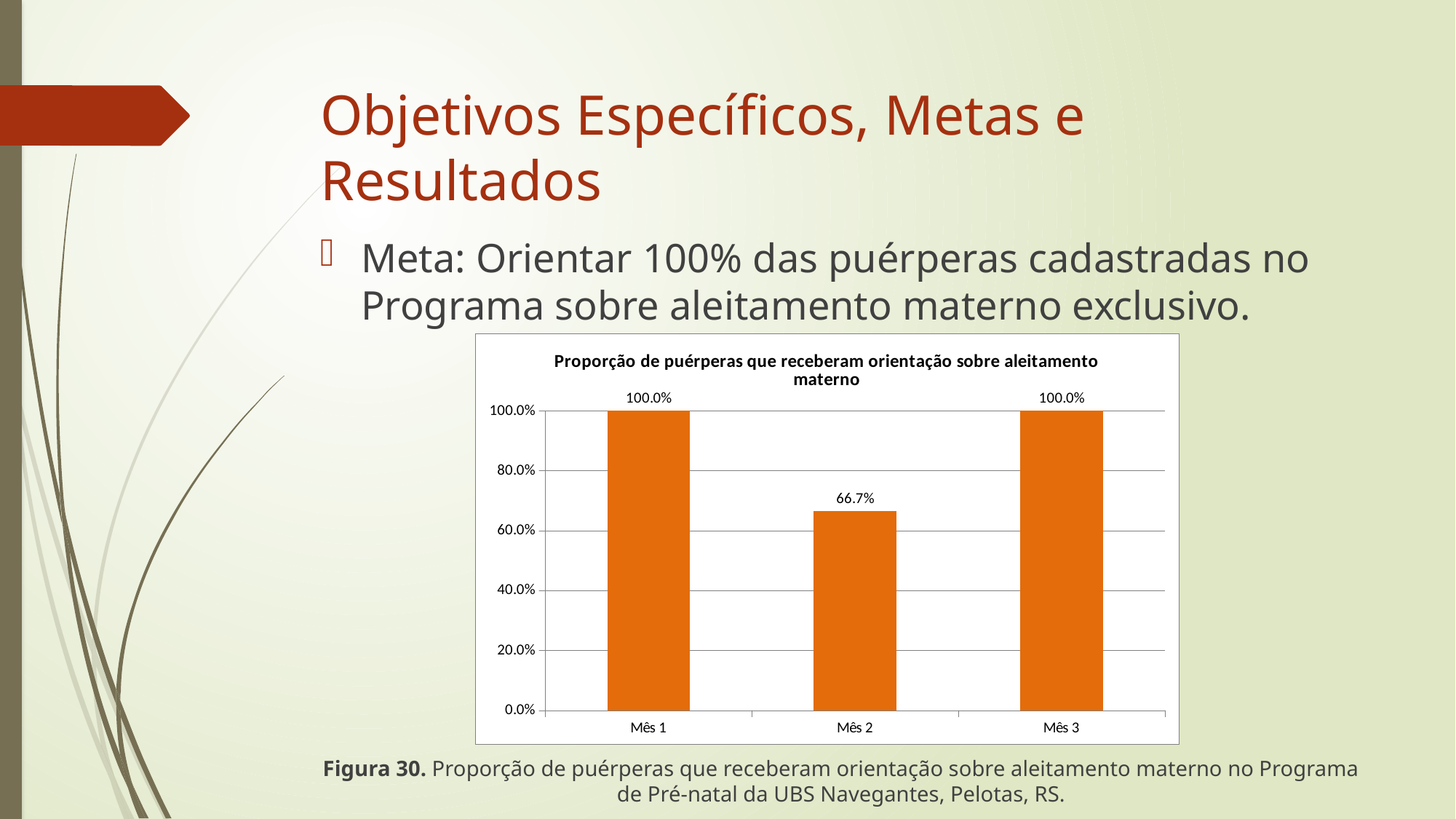
What colour are the bars in the chart? orange What is the difference between the values for Mês 1 and Mês 2? 33.3% What is the title of the chart? Proporção de puérperas que receberam orientação sobre aleitamento materno What kind of chart is shown on the slide? bar chart What is the value for Mês 3? 100.0% Which month has the lowest value? Mês 2 Which is larger, the value for Mês 2 or the value for Mês 3? Mês 3 What is the value for Mês 1? 100.0% What is the value for Mês 2? 66.7% Does the value rise or fall from Mês 2 to Mês 3? rise How many months are shown on the x axis? 3 Is the value for Mês 2 greater or less than 80.0%? less